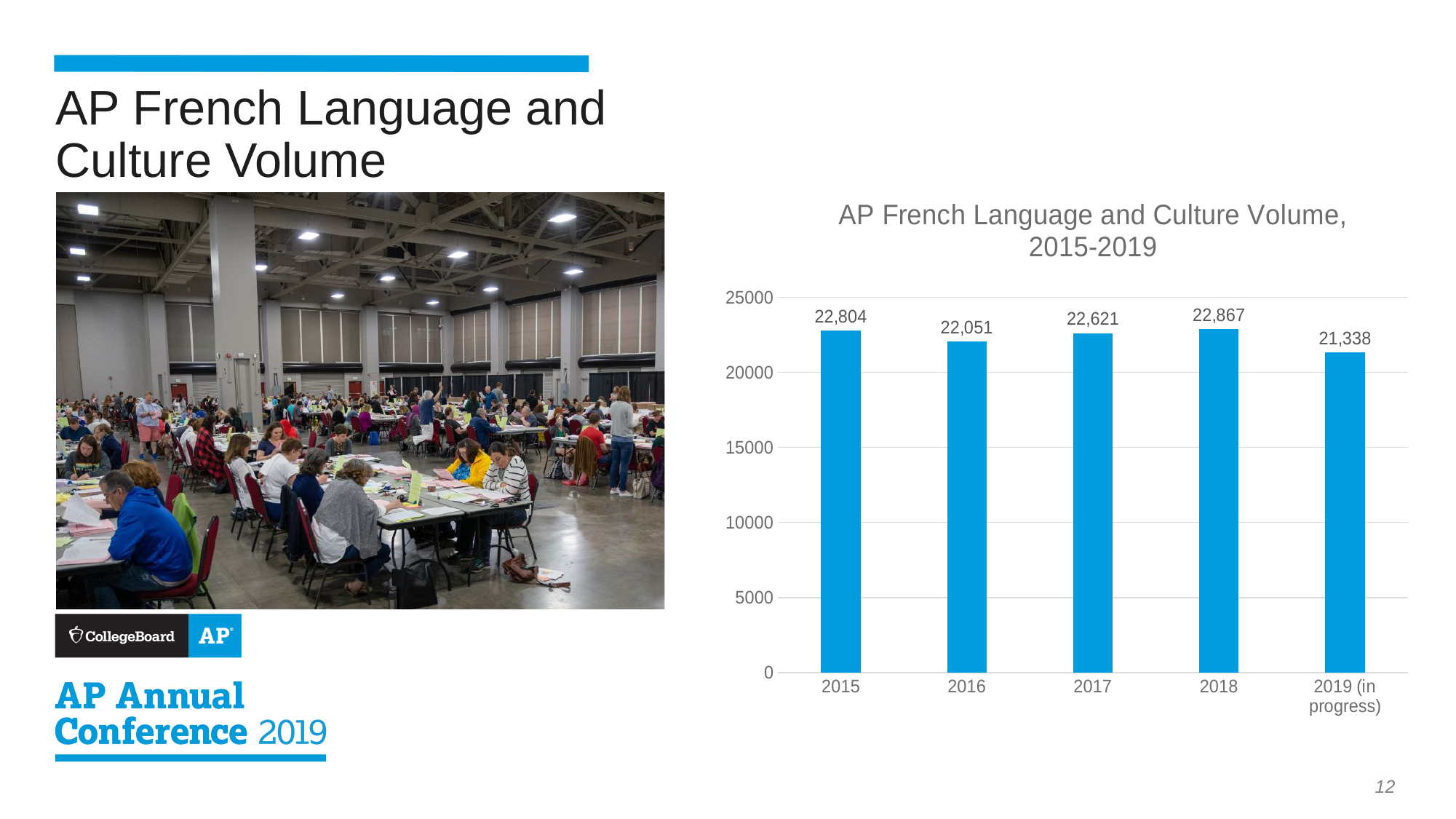
Which year has the highest AP French Language and Culture volume? 2018 How many years are shown on the chart? 5 What is the volume shown for 2019 (in progress)? 21,338 What is the title of the chart? AP French Language and Culture Volume, 2015-2019 What is the AP French Language and Culture volume for 2015? 22,804 Which year has a larger volume, 2016 or 2017? 2017 What is the AP French Language and Culture volume for 2017? 22,621 Is the value for 2019 (in progress) greater or less than 20000? greater Which year has the lowest volume on the chart? 2019 (in progress) What kind of chart is shown on the slide? Bar chart What is the difference between the 2018 volume and the 2019 (in progress) volume? 1,529 What is the difference between the 2015 volume and the 2016 volume? 753